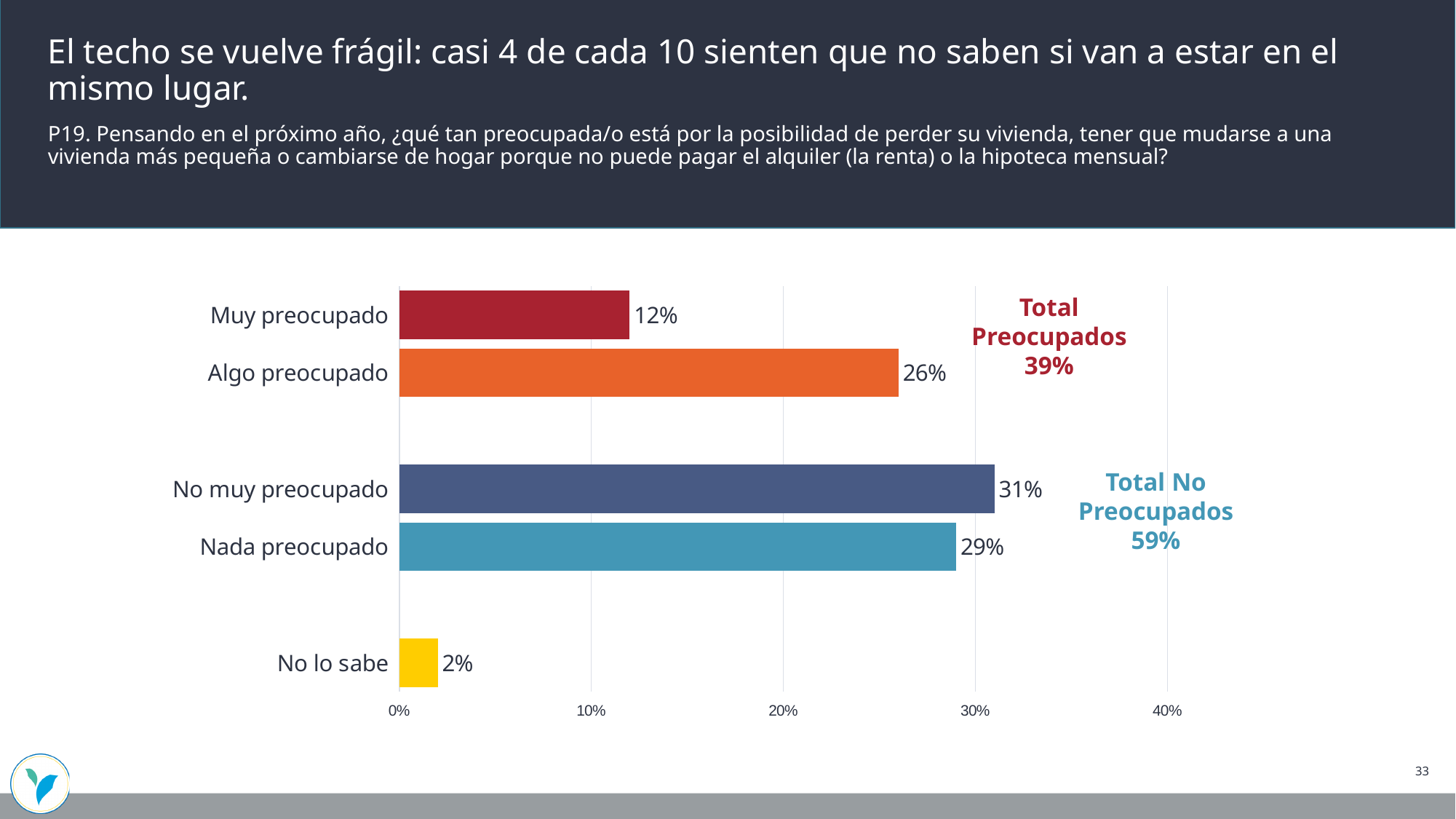
What is the value for "Nada preocupado"? 29% What is the difference between "No muy preocupado" and "Muy preocupado"? 19% What is the value for "No lo sabe"? 2% What is the "Total No Preocupados" percentage shown next to the chart? 59% What is the "Total Preocupados" percentage shown next to the chart? 39% Is the value for "Muy preocupado" greater or less than 10%? greater How many categories are shown in the chart? 5 Which category has the highest value? No muy preocupado What is the value for "Algo preocupado"? 26% Which is larger, "Algo preocupado" or "Nada preocupado"? Nada preocupado What kind of chart is shown on the slide? bar chart Which category has the lowest value? No lo sabe